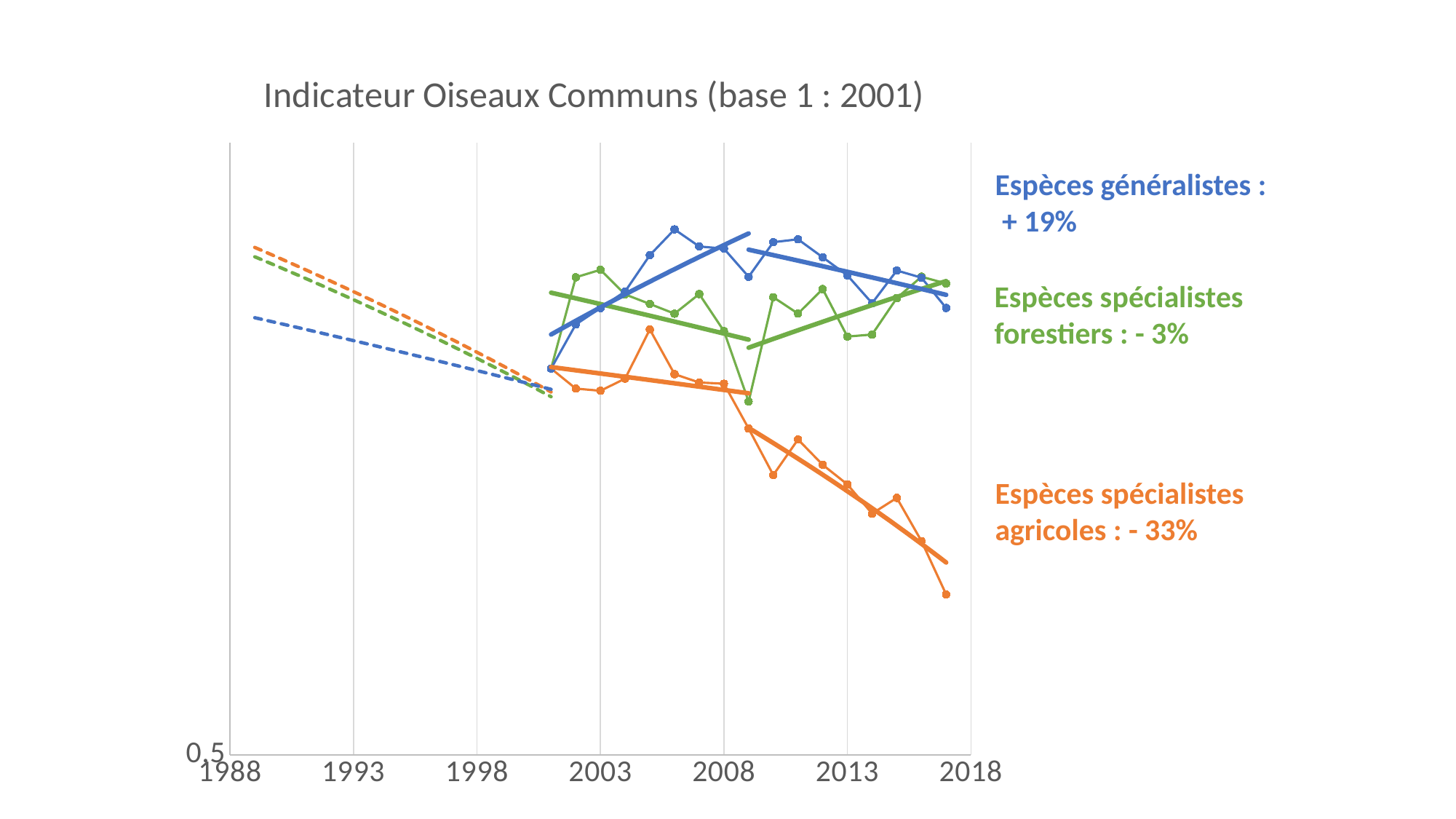
What is the first year shown on the x axis? 1988 Which species group shows the largest increase according to the annotations? Espèces généralistes Does the Espèces spécialistes agricoles line rise or fall between 2008 and 2018? fall What percentage change is given for Espèces spécialistes forestiers? - 3% What kind of chart is shown on the slide? line chart What percentage change is given for Espèces spécialistes agricoles? - 33% Which colour is used for the Espèces spécialistes agricoles series? orange How many species groups (series) are plotted on the chart? 3 Which species group shows the largest decline according to the annotations? Espèces spécialistes agricoles What percentage change is given for Espèces généralistes? + 19% What is the title of the chart? Indicateur Oiseaux Communs (base 1 : 2001) Does the Espèces généralistes line rise or fall between 2001 and 2008? rise